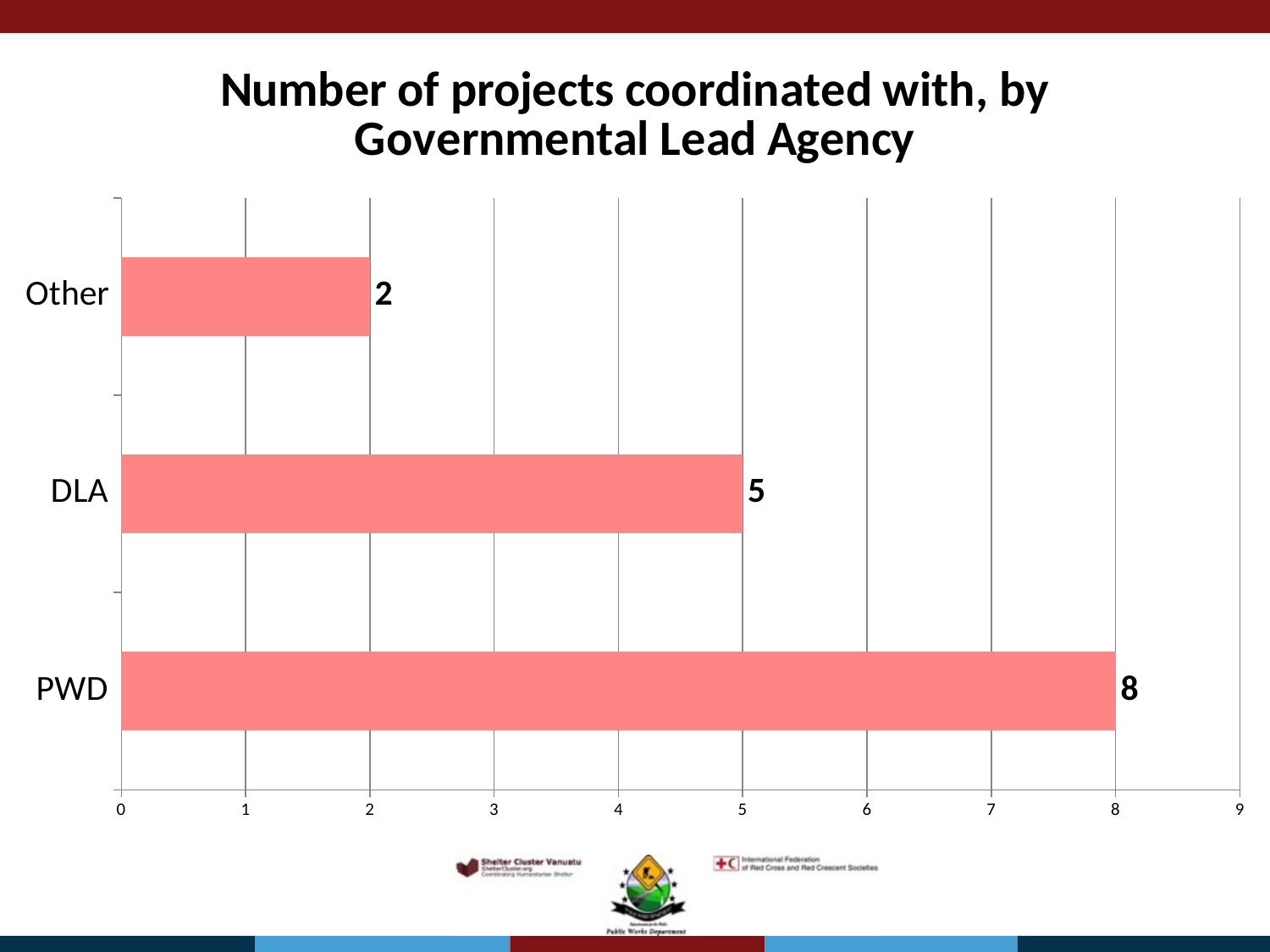
What is the number of projects coordinated with DLA? 5 What is the title of the chart? Number of projects coordinated with, by Governmental Lead Agency Which category has the lowest number of projects coordinated with? Other Is the value for PWD greater or less than 6? greater What kind of chart is shown on the slide? Bar chart What is the number of projects coordinated with Other? 2 What is the difference between the number of projects for DLA and Other? 3 How many categories are shown in the chart? 3 What is the number of projects coordinated with PWD? 8 What is the difference between the number of projects for PWD and DLA? 3 Which has more projects coordinated with, DLA or Other? DLA Which governmental lead agency has the highest number of projects coordinated with? PWD